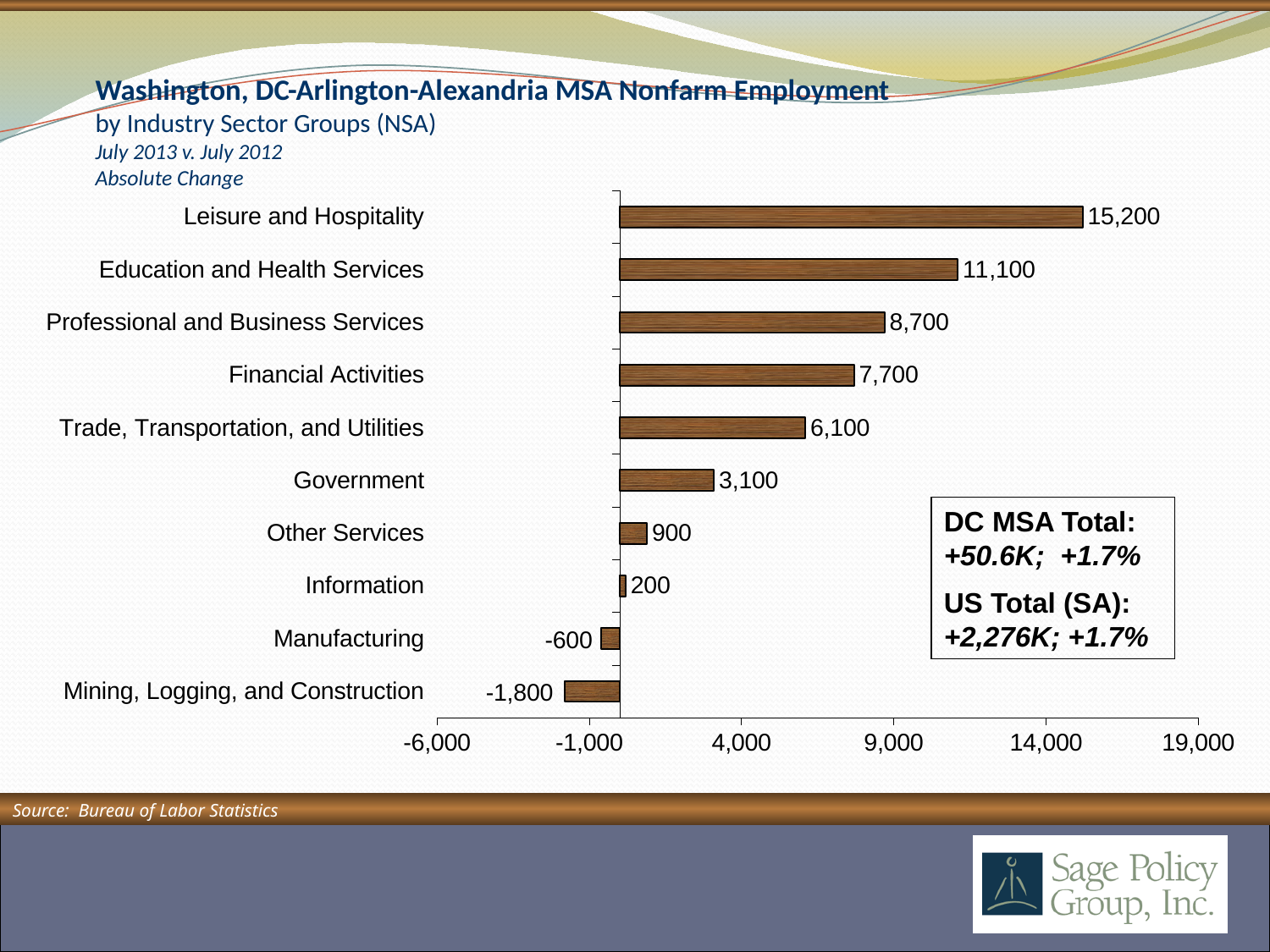
How many industry sector groups show a negative absolute change? 2 What is the absolute change in employment for Leisure and Hospitality? 15,200 What is the DC MSA total change shown in the text box on the chart? +50.6K; +1.7% What kind of chart is shown on the slide? Bar chart How many industry sector groups are shown in the chart? 10 What is the difference between the absolute change for Education and Health Services and for Professional and Business Services? 2,400 Which industry sector group has the largest absolute change? Leisure and Hospitality Which industry sector group has the lowest absolute change? Mining, Logging, and Construction Which has a larger absolute change, Financial Activities or Trade, Transportation, and Utilities? Financial Activities What is the absolute change in employment for Government? 3,100 What is the absolute change in employment for Information? 200 What is the absolute change in employment for Mining, Logging, and Construction? -1,800